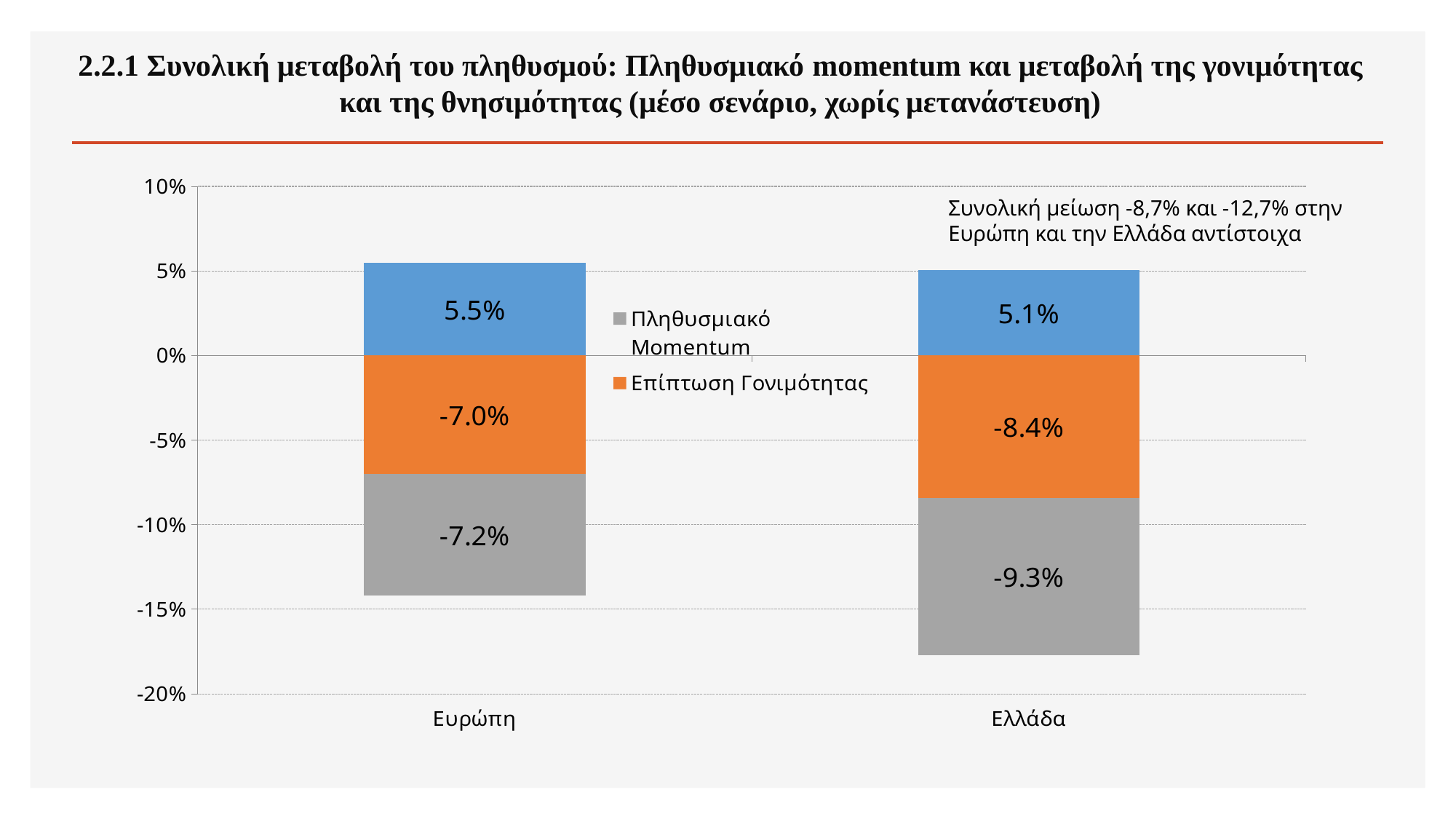
Which category has the lower Πληθυσμιακό Momentum value? Ελλάδα What is the difference between the Επίπτωση Γονιμότητας values for Ελλάδα and Ευρώπη? 1.4 percentage points What kind of chart is shown on the slide? Stacked bar chart What is the Επίπτωση Γονιμότητας value for Ελλάδα? -8.4% What is the Πληθυσμιακό Momentum value for Ελλάδα? -9.3% Which category has the higher value in the blue (positive) segment? Ευρώπη What is the difference between the Πληθυσμιακό Momentum values for Ευρώπη and Ελλάδα? 2.1 percentage points What is the Επίπτωση Γονιμότητας value for Ευρώπη? -7.0% What is the value of the blue (positive) segment for Ελλάδα? 5.1% What is the Πληθυσμιακό Momentum value for Ευρώπη? -7.2% What is the net total of the stacked bar for Ευρώπη? -8.7% How many categories are shown on the x axis? 2